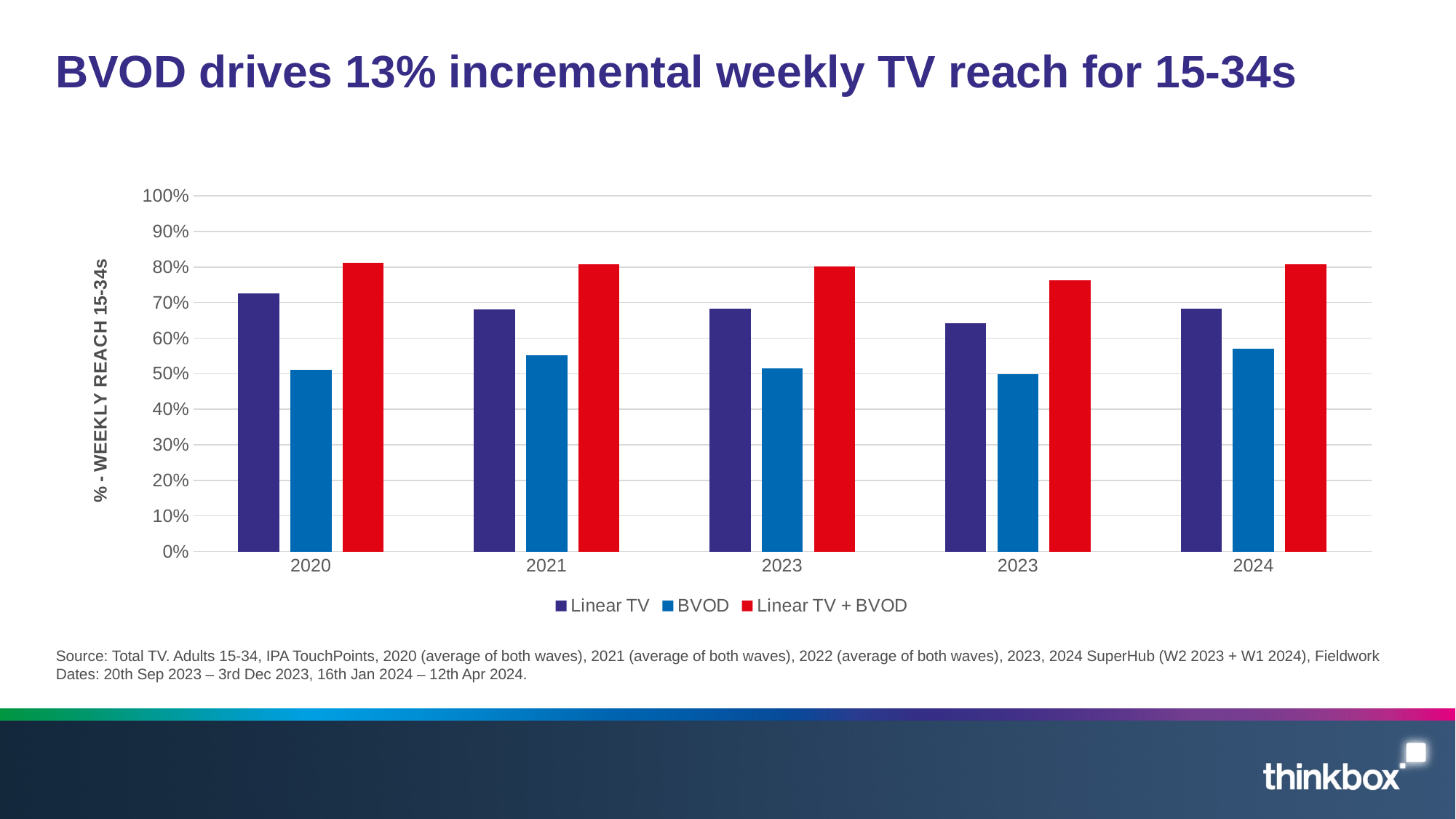
Which series has the lowest bar in 2024? BVOD Is the Linear TV + BVOD value for 2024 greater or less than 70%? greater What kind of chart is shown on the slide? bar chart How many year categories are shown on the x axis? 5 How many series does the legend list? 3 Which is larger: the BVOD value for 2020 or the BVOD value for 2024? 2024 Which series has the highest bar in 2020? Linear TV + BVOD Is the Linear TV value for 2020 greater or less than 70%? greater Is the BVOD value for 2021 greater or less than 60%? less What is the title of the vertical axis? % - WEEKLY REACH 15-34s Which is larger: the Linear TV value for 2020 or the Linear TV value for 2024? 2020